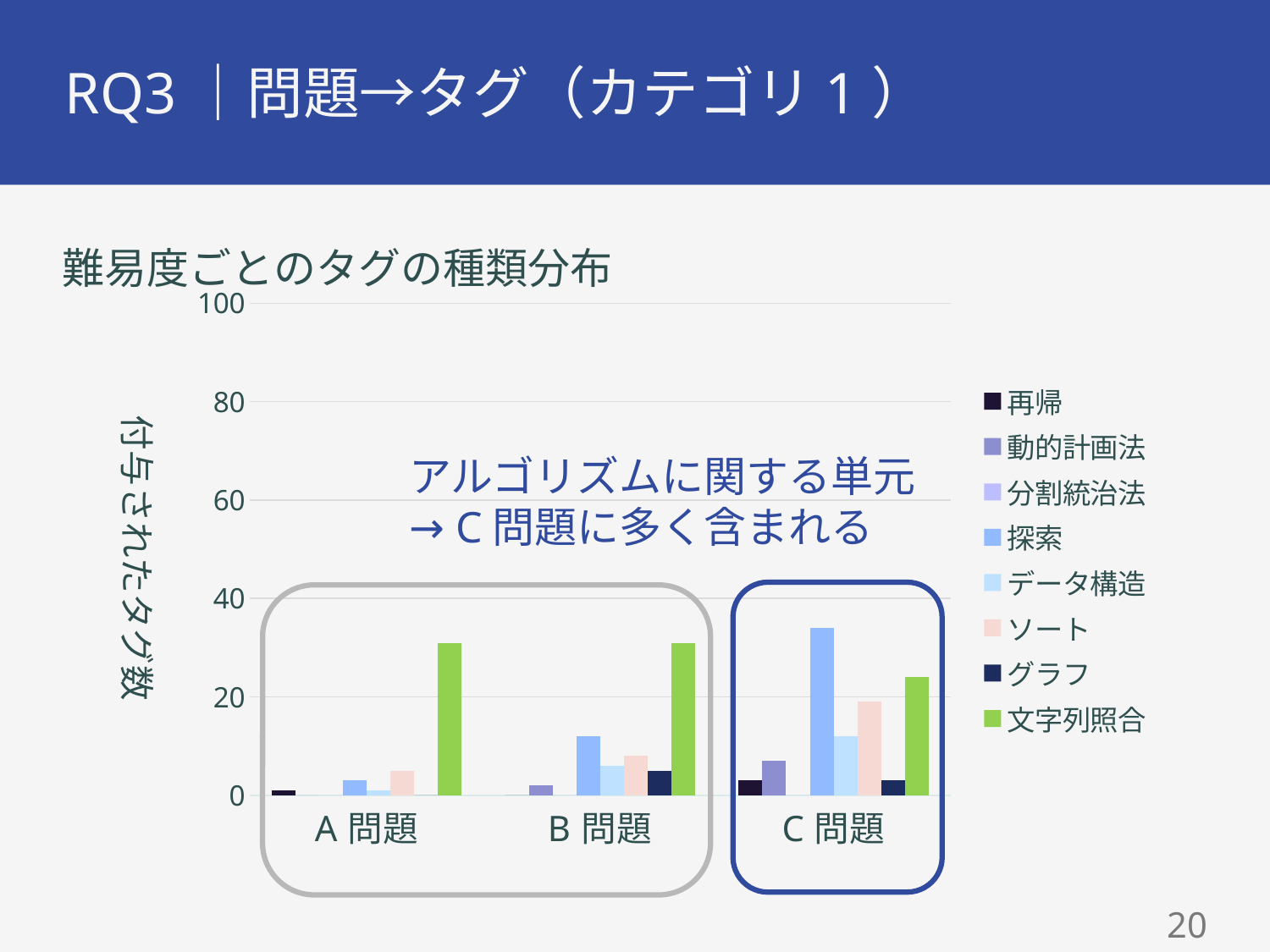
What kind of chart is shown on the slide? bar chart Which is larger: the value of 探索 for A 問題 or for C 問題? C 問題 What is the label on the vertical axis of the chart? 付与されたタグ数 How many series does the chart's legend list? 8 Which series has the highest value for C 問題? 探索 What is the title of the chart? 難易度ごとのタグの種類分布 Is the value of 探索 for B 問題 greater or less than 20? less Is the value of 探索 for C 問題 greater or less than 20? greater Which series has the highest value for A 問題? 文字列照合 How many categories are shown on the x axis of the chart? 3 Does the value of 探索 rise or fall from A 問題 to C 問題? rise Is the value of 文字列照合 for A 問題 greater or less than 20? greater